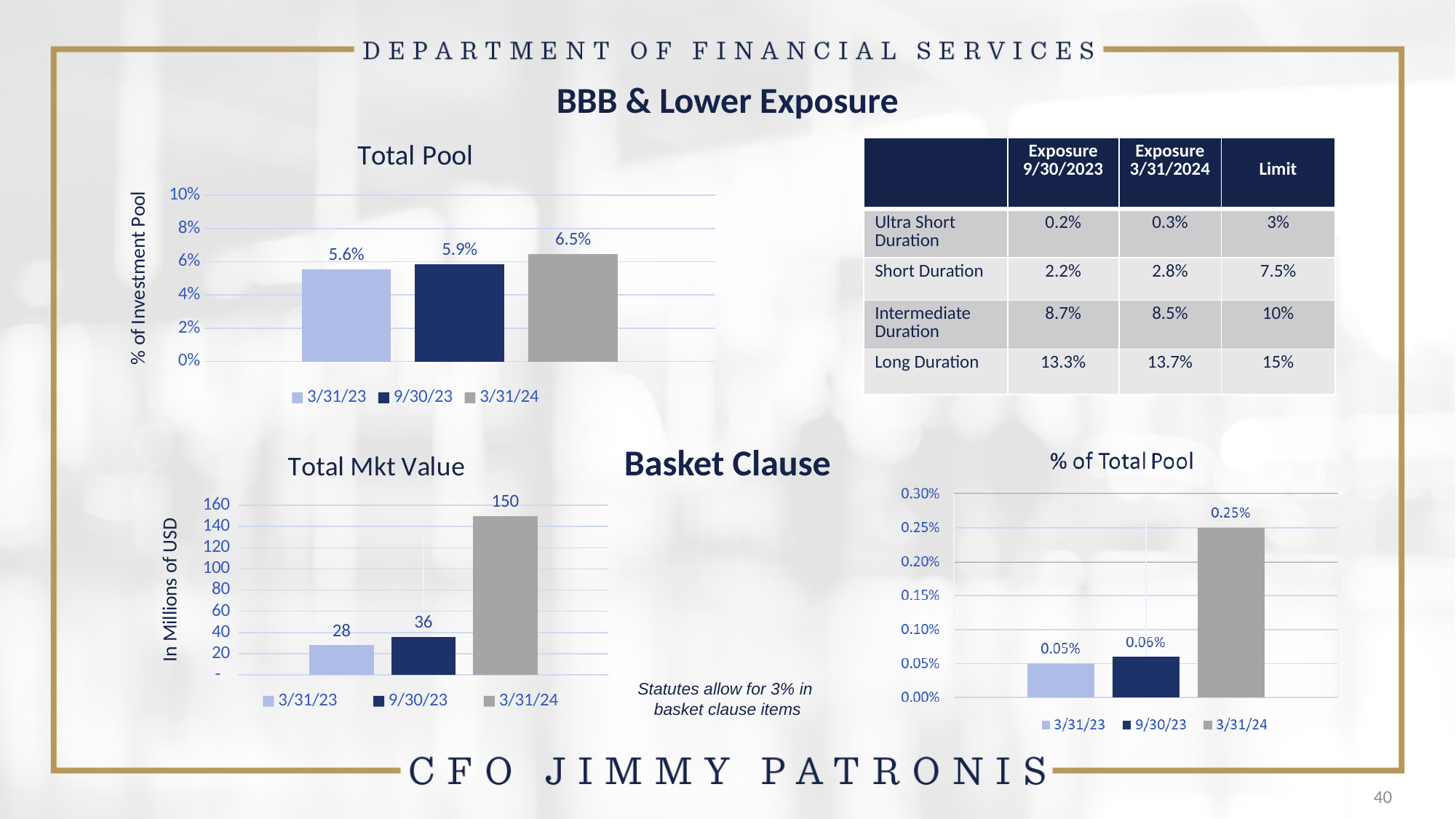
In the Total Pool chart, what is the difference between the 3/31/24 and 3/31/23 values? 0.9% What is the y-axis label of the Total Mkt Value chart? In Millions of USD In the Total Pool chart, what is the value for 3/31/24? 6.5% In the Total Pool chart, how many series does the legend list? 3 In the Total Mkt Value chart, do the values rise or fall from 3/31/23 to 3/31/24? rise In the Total Mkt Value chart, which date has the highest value? 3/31/24 In the % of Total Pool chart, what is the value for 3/31/24? 0.25% What kind of chart is the % of Total Pool chart? bar chart In the Total Pool chart, which date has the lowest value? 3/31/23 In the Total Mkt Value chart, what is the difference between the 3/31/24 and 9/30/23 values? 114 In the Total Mkt Value chart, what is the value for 9/30/23? 36 In the % of Total Pool chart, which is larger, the value for 3/31/23 or 9/30/23? 9/30/23